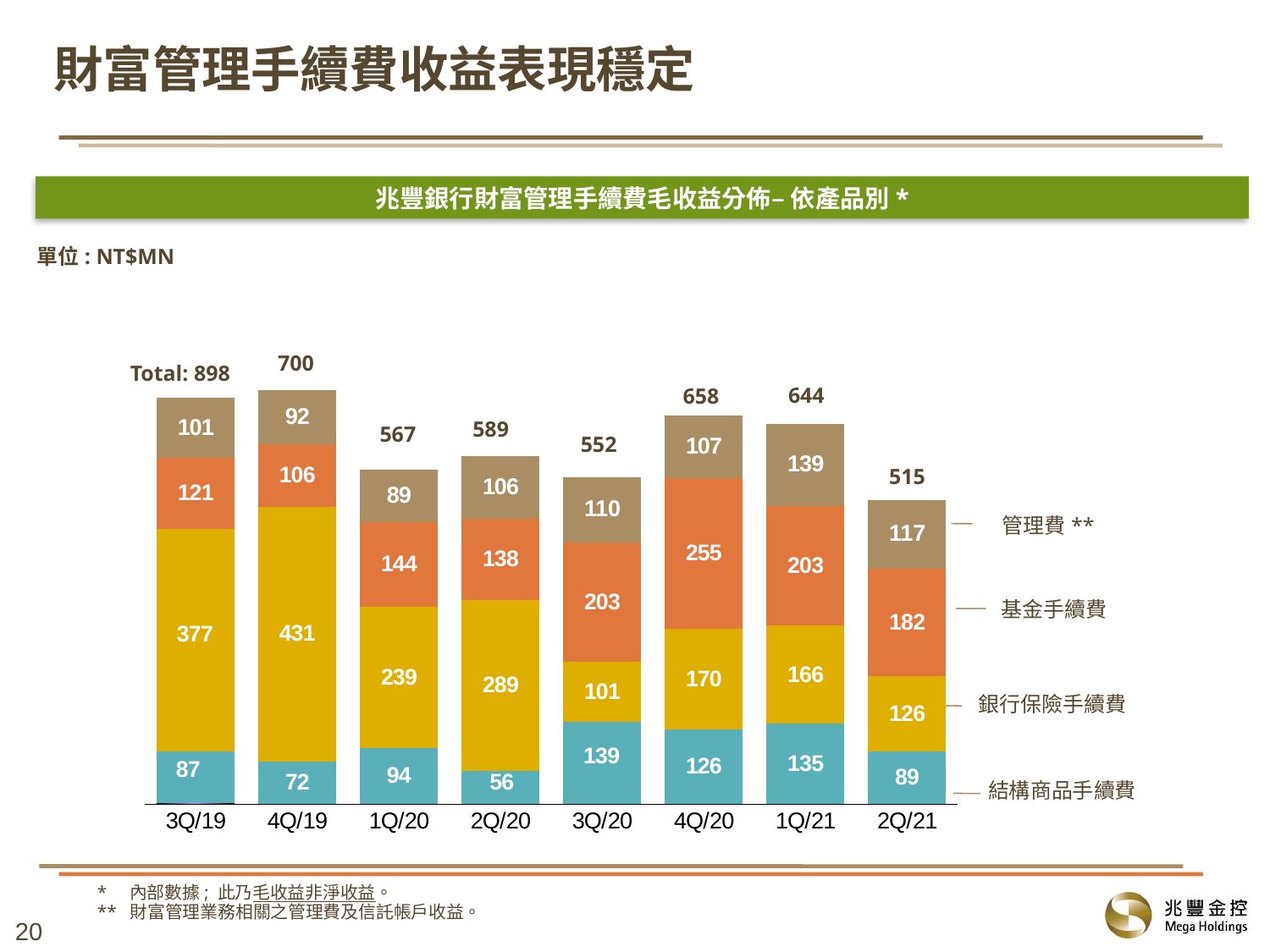
What is the value of 結構商品手續費 for 2Q/20? 56 What is the difference between the total for 4Q/19 and the total for 2Q/21? 185 Which quarter has the lowest total fee income? 2Q/21 What is the total wealth management fee income for 3Q/19? 898 What type of chart is shown on the slide? Stacked bar chart How many quarters are shown on the x axis of the chart? 8 Which is larger, 銀行保險手續費 in 3Q/20 or 銀行保險手續費 in 4Q/20? 4Q/20 How many series (product categories) are labelled in the chart? 4 Which quarter has the highest total fee income? 3Q/19 What is the value of 管理費 for 1Q/21? 139 What is the value of 銀行保險手續費 for 4Q/19? 431 What is the value of 基金手續費 for 4Q/20? 255